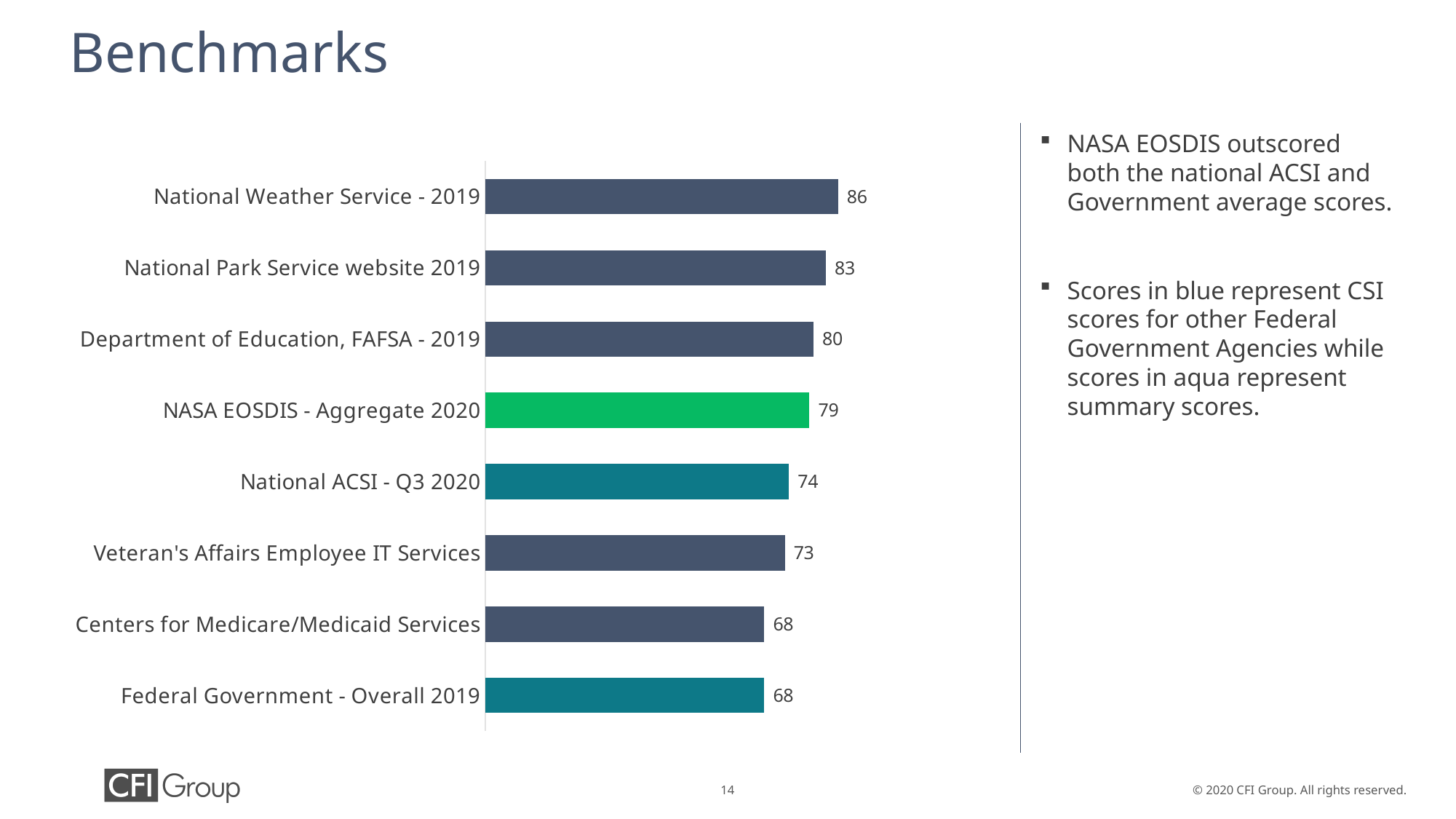
What is the difference between NASA EOSDIS - Aggregate 2020 and Federal Government - Overall 2019? 11 What is the value for NASA EOSDIS - Aggregate 2020? 79 What is the value for National ACSI - Q3 2020? 74 What is the value for Centers for Medicare/Medicaid Services? 68 How many categories are shown in the chart? 8 What is the value for National Weather Service - 2019? 86 Which category has the highest value? National Weather Service - 2019 Which is larger, NASA EOSDIS - Aggregate 2020 or National ACSI - Q3 2020? NASA EOSDIS - Aggregate 2020 Which is larger, Department of Education, FAFSA - 2019 or Veteran's Affairs Employee IT Services? Department of Education, FAFSA - 2019 What kind of chart is shown on the slide? Bar chart What colour is the bar for NASA EOSDIS - Aggregate 2020? Green What is the difference between National Weather Service - 2019 and National Park Service website 2019? 3